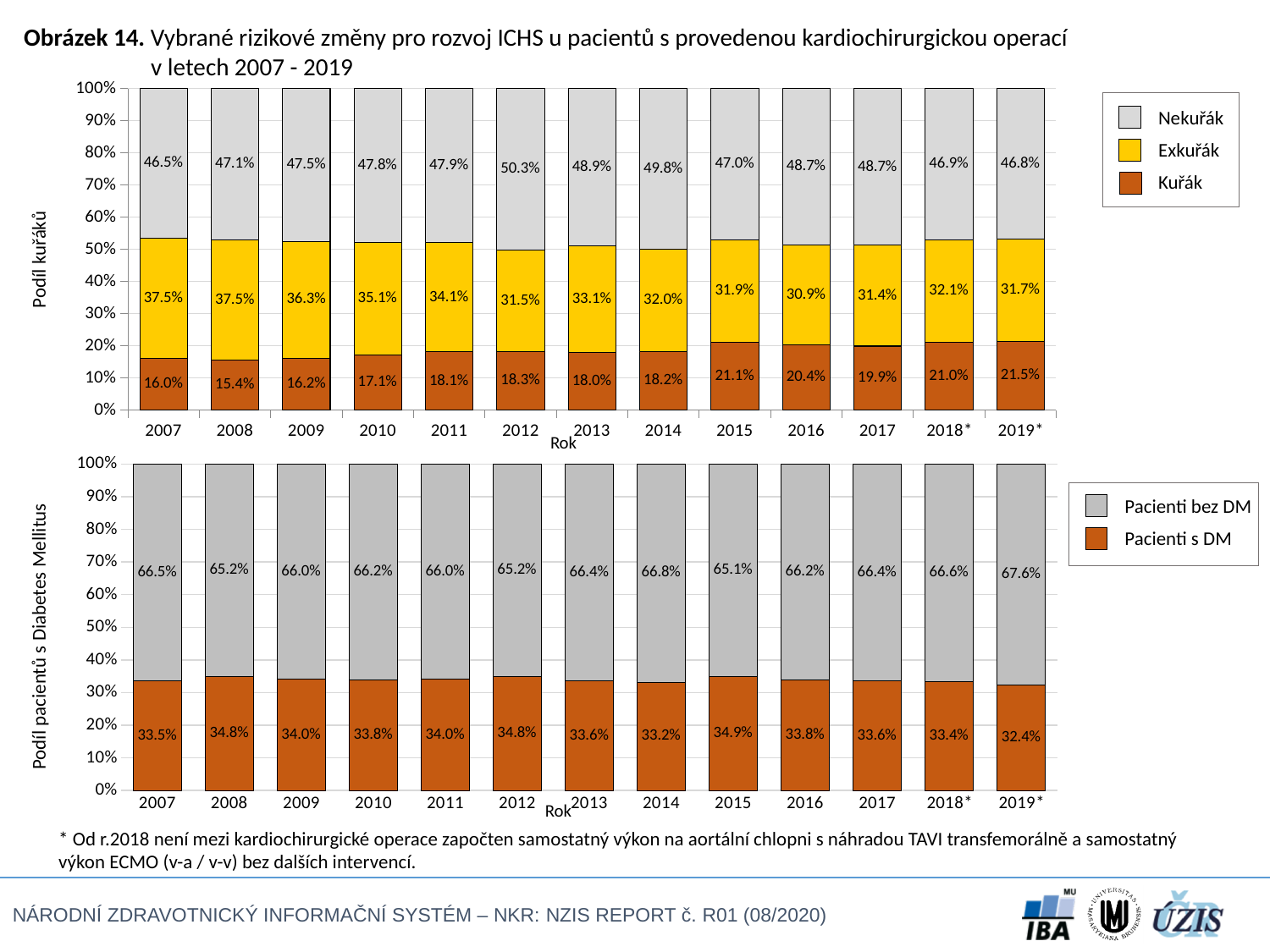
In the bottom chart (Podíl pacientů s Diabetes Mellitus), which year has the highest Pacienti s DM share? 2015 In the top chart (Podíl kuřáků), which year has the lowest Exkuřák share? 2016 In the top chart (Podíl kuřáků), what is the value for Nekuřák in 2012? 50.3% In the bottom chart (Podíl pacientů s Diabetes Mellitus), what is the value for Pacienti s DM in 2008? 34.8% In the top chart (Podíl kuřáků), which year has the highest Kuřák share? 2019* In the top chart (Podíl kuřáků), what is the difference between the Exkuřák values for 2007 and 2019*? 5.8 percentage points In the top chart (Podíl kuřáků), which year has the lowest Kuřák share? 2008 In the top chart (Podíl kuřáků), what is the value for Kuřák in 2015? 21.1% How many years are shown on the x axis of the bottom chart (Podíl pacientů s Diabetes Mellitus)? 13 In the bottom chart (Podíl pacientů s Diabetes Mellitus), is the Pacienti bez DM value for 2019* larger or smaller than the value for 2015? larger In the bottom chart (Podíl pacientů s Diabetes Mellitus), which year has the lowest Pacienti s DM share? 2019* In the top chart (Podíl kuřáků), how many series does the legend list? 3